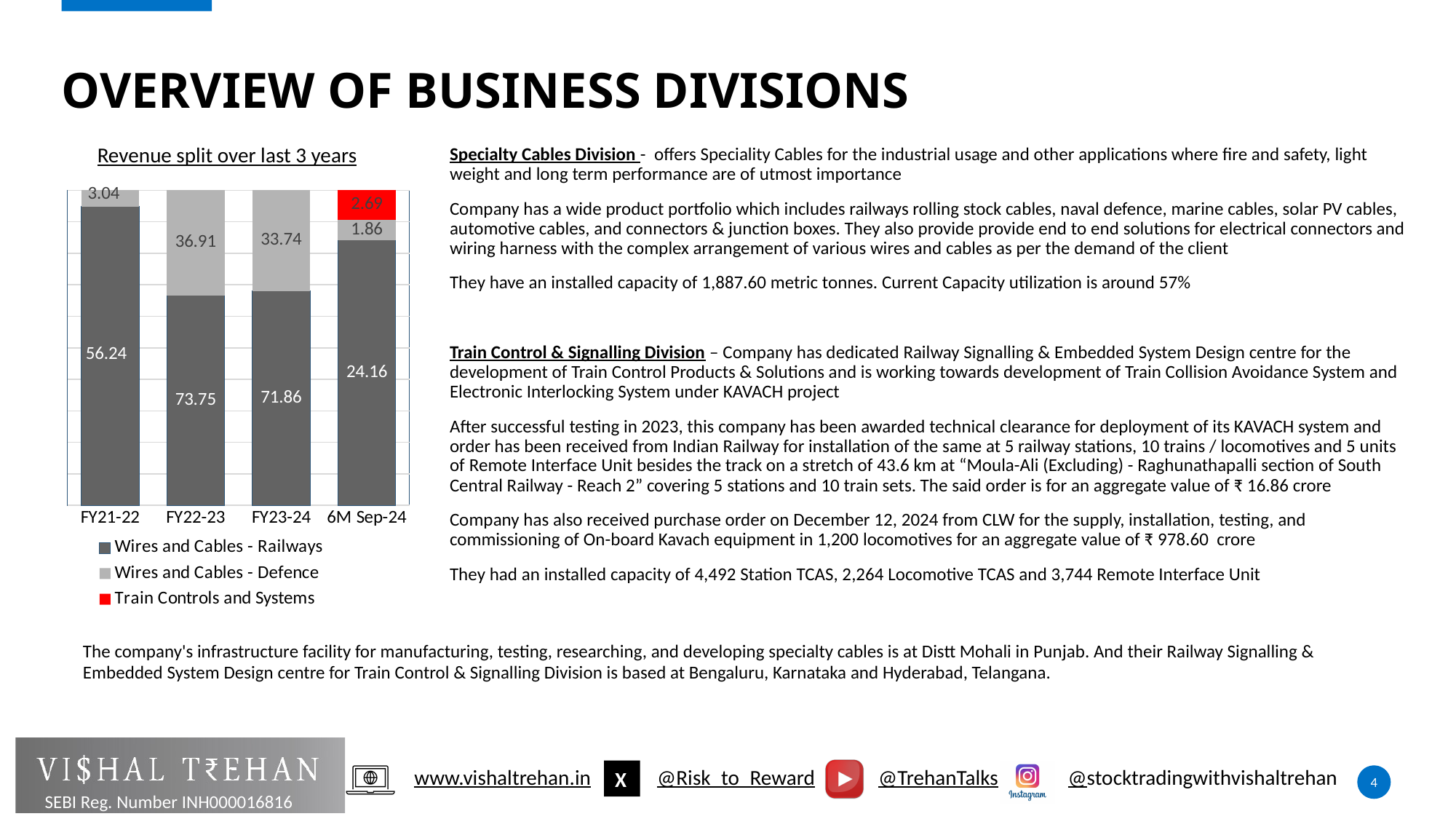
Which series in the revenue split chart is shown in red? Train Controls and Systems What is the value for Wires and Cables - Railways in FY22-23? 73.75 How many series does the legend of the revenue split chart list? 3 What is the difference between the Wires and Cables - Defence values for FY22-23 and FY23-24? 3.17 Which category has the highest value for Wires and Cables - Railways? FY22-23 How many categories are shown on the x axis of the revenue split chart? 4 What is the value for Wires and Cables - Defence in FY23-24? 33.74 What is the value for Train Controls and Systems in 6M Sep-24? 2.69 What type of chart is shown under the title 'Revenue split over last 3 years'? Stacked bar chart What is the total of the stacked bar for FY21-22? 59.28 Which category has the lowest value for Wires and Cables - Defence? 6M Sep-24 Which is larger: Wires and Cables - Railways in FY21-22 or in FY23-24? FY23-24